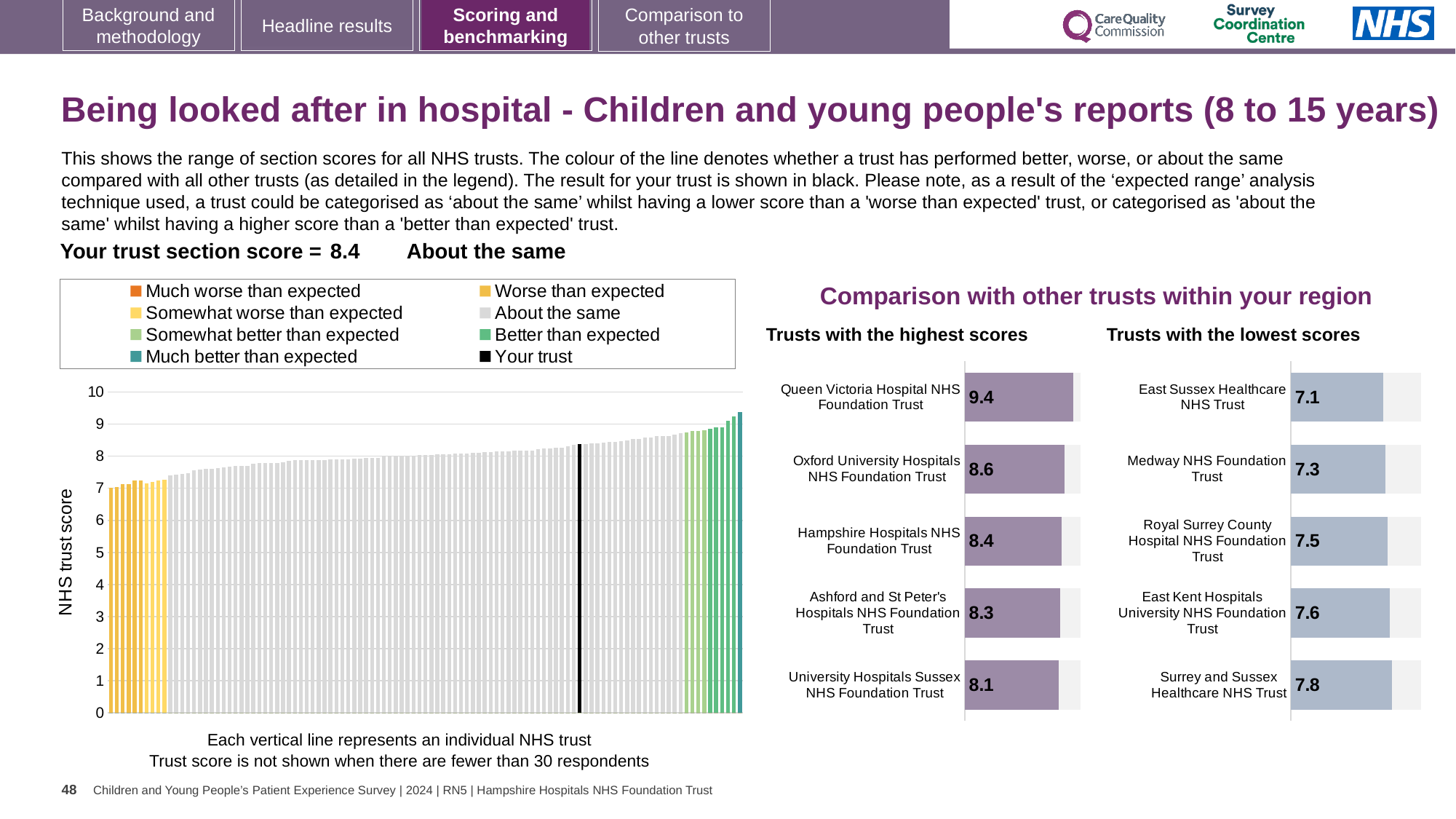
In the 'Trusts with the lowest scores' chart, what is the difference between the scores of Surrey and Sussex Healthcare NHS Trust and East Sussex Healthcare NHS Trust? 0.7 What is the label of the vertical axis on the large chart on the left? NHS trust score In the 'Trusts with the highest scores' chart, what is the score for Hampshire Hospitals NHS Foundation Trust? 8.4 In the 'Trusts with the lowest scores' chart, what is the score for Medway NHS Foundation Trust? 7.3 In the 'Trusts with the lowest scores' chart, which has the higher score: Royal Surrey County Hospital NHS Foundation Trust or East Kent Hospitals University NHS Foundation Trust? East Kent Hospitals University NHS Foundation Trust In the 'Trusts with the highest scores' chart, what is the score for Queen Victoria Hospital NHS Foundation Trust? 9.4 What kind of chart is the large chart on the left showing NHS trust scores? Bar chart In the 'Trusts with the highest scores' chart, which trust has the highest score? Queen Victoria Hospital NHS Foundation Trust In the 'Trusts with the lowest scores' chart, which trust has the lowest score? East Sussex Healthcare NHS Trust In the 'Trusts with the highest scores' chart, what is the difference between the scores of Queen Victoria Hospital NHS Foundation Trust and University Hospitals Sussex NHS Foundation Trust? 1.3 How many trusts are shown in the 'Trusts with the highest scores' chart? 5 How many entries does the legend of the large chart on the left list? 8